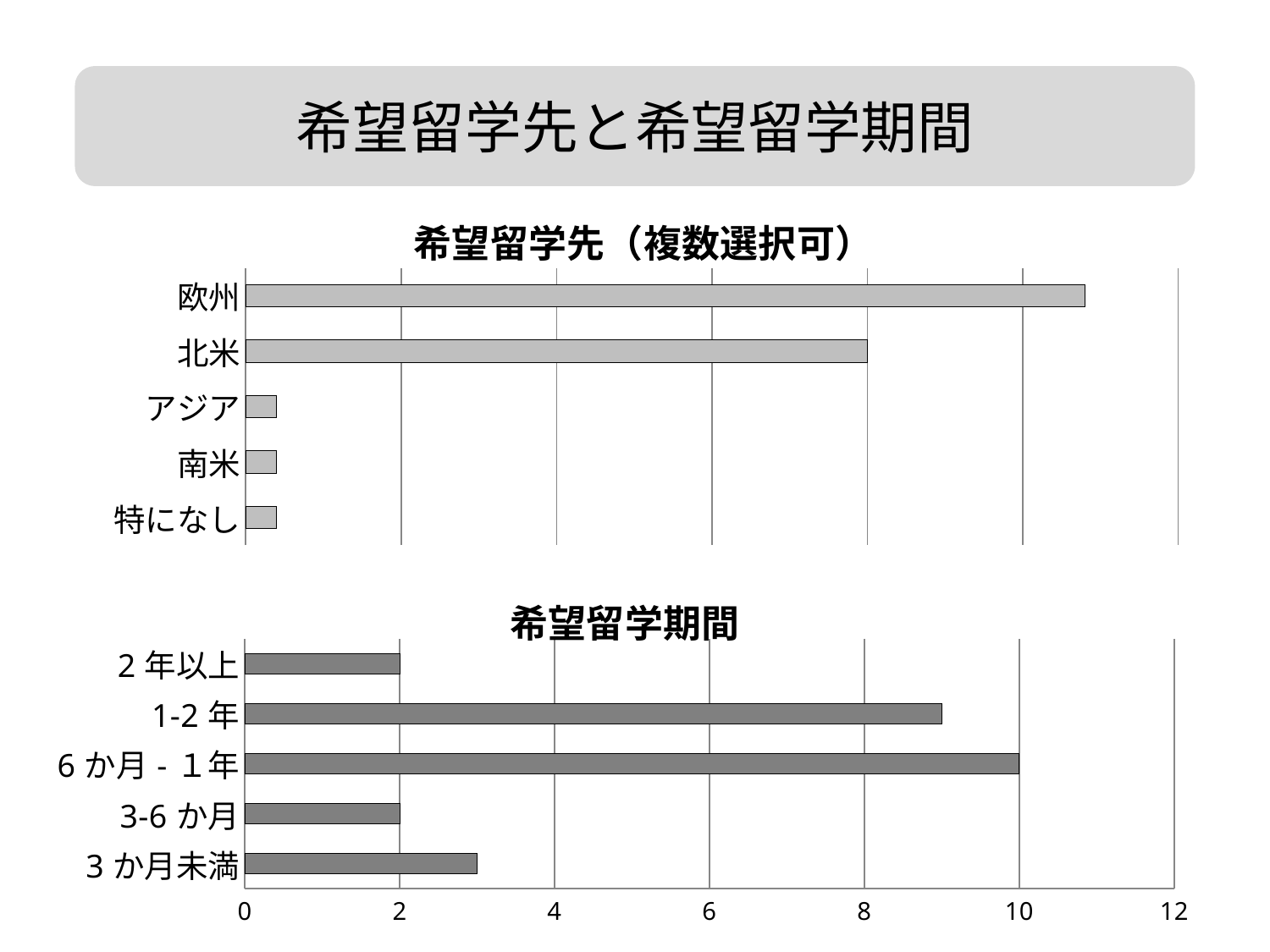
In the 希望留学期間 chart, which category has the highest value? 6か月-1年 In the 希望留学期間 chart, what is the difference between the values for 6か月-1年 and 3-6か月? 8 In the 希望留学先（複数選択可） chart, which is larger, the value for 欧州 or the value for 北米? 欧州 In the 希望留学期間 chart, what is the value for 6か月-1年? 10 In the 希望留学期間 chart, what is the value for 2年以上? 2 In the 希望留学期間 chart, what is the value for 3-6か月? 2 In the 希望留学期間 chart, which is larger, the value for 1-2年 or the value for 3か月未満? 1-2年 In the 希望留学先（複数選択可） chart, which category has the highest value? 欧州 How many categories are shown in the 希望留学先（複数選択可） chart? 5 What kind of chart is the 希望留学期間 chart? bar chart In the 希望留学期間 chart, is the value for 3か月未満 greater or less than 4? less In the 希望留学期間 chart, is the value for 1-2年 greater or less than 8? greater